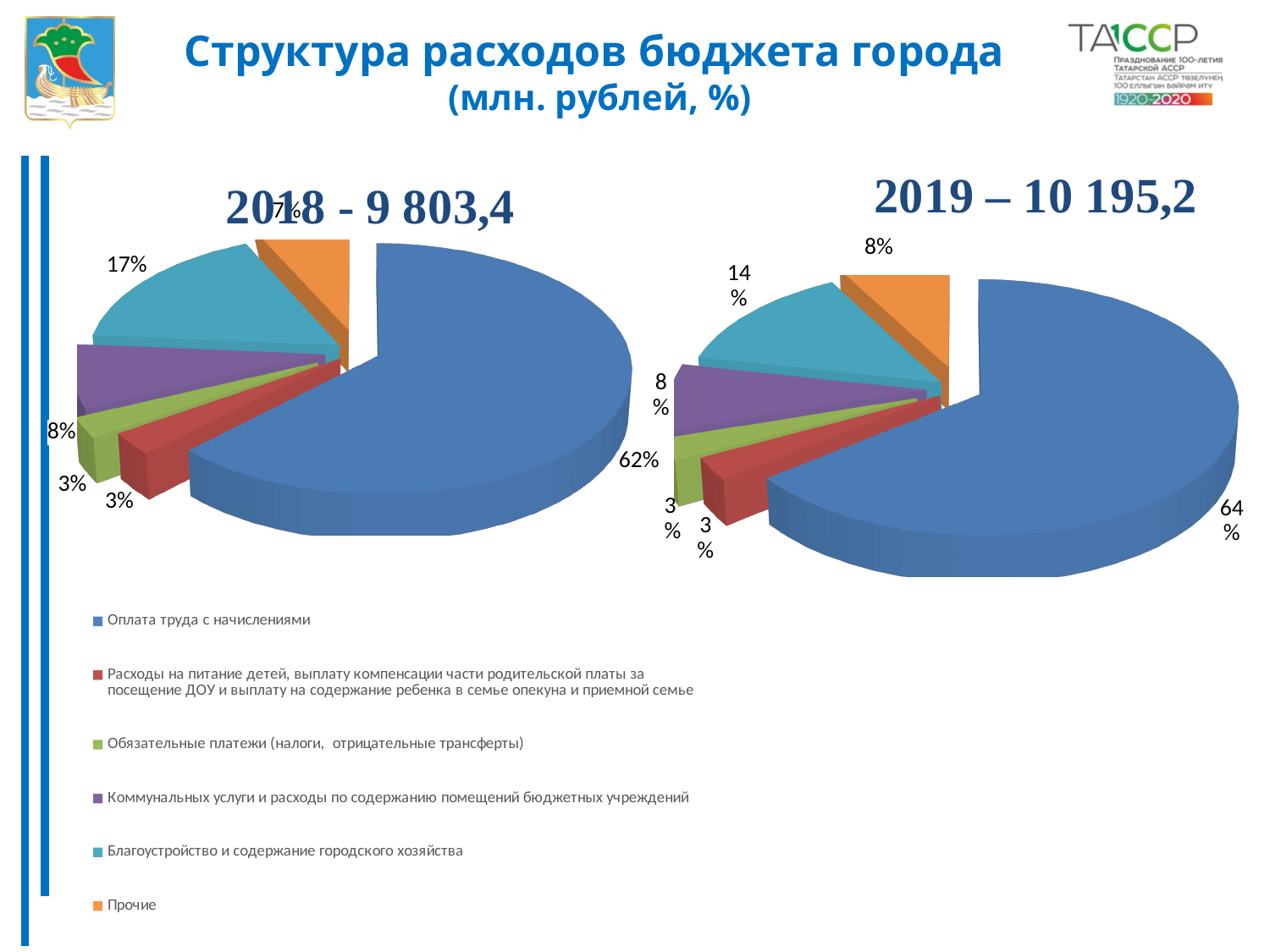
What total value is shown in the title of the 2019 pie chart? 10 195,2 In the 2018 pie chart, what share does "Прочие" have? 7% In the 2019 pie chart, what share does "Оплата труда с начислениями" have? 64% In the 2019 pie chart, what share does "Благоустройство и содержание городского хозяйства" have? 14% What type of chart is used on this slide? pie chart By how many percentage points does the share of "Благоустройство и содержание городского хозяйства" differ between the 2018 and 2019 pie charts? 3 How many categories does the legend list? 6 In the 2018 pie chart, which category has the largest share? Оплата труда с начислениями